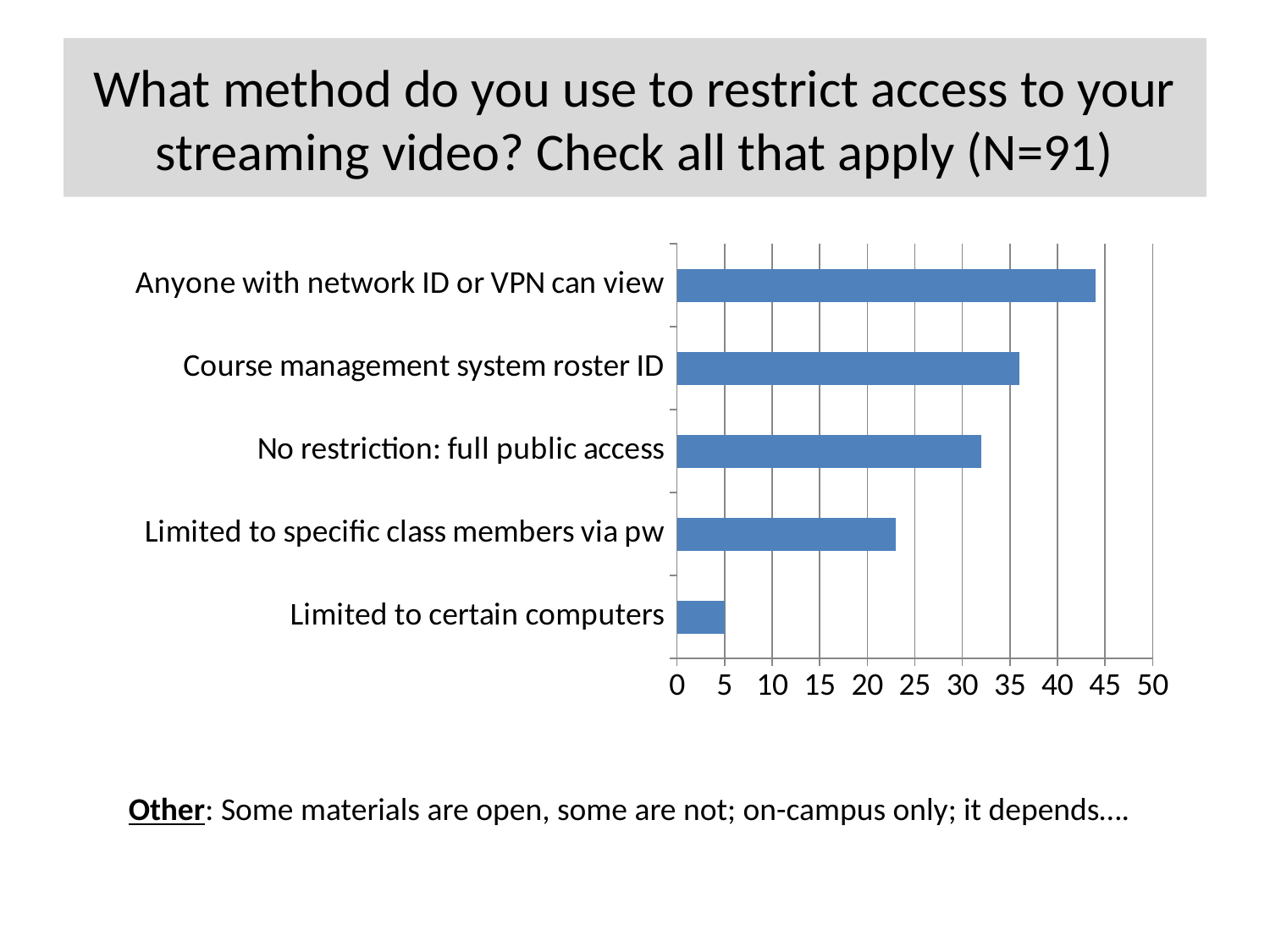
What kind of chart is shown on the slide? bar chart Is the value for No restriction: full public access greater or less than 30? greater Which category has the lowest value? Limited to certain computers What is the maximum value shown on the horizontal axis? 50 Which is larger: the value for Limited to specific class members via pw or the value for Limited to certain computers? Limited to specific class members via pw How many categories does the chart show? 5 Is the value for Course management system roster ID greater or less than 40? less Is the value for Limited to specific class members via pw greater or less than 25? less Which is larger: the value for Course management system roster ID or the value for No restriction: full public access? Course management system roster ID Which category has the highest value? Anyone with network ID or VPN can view